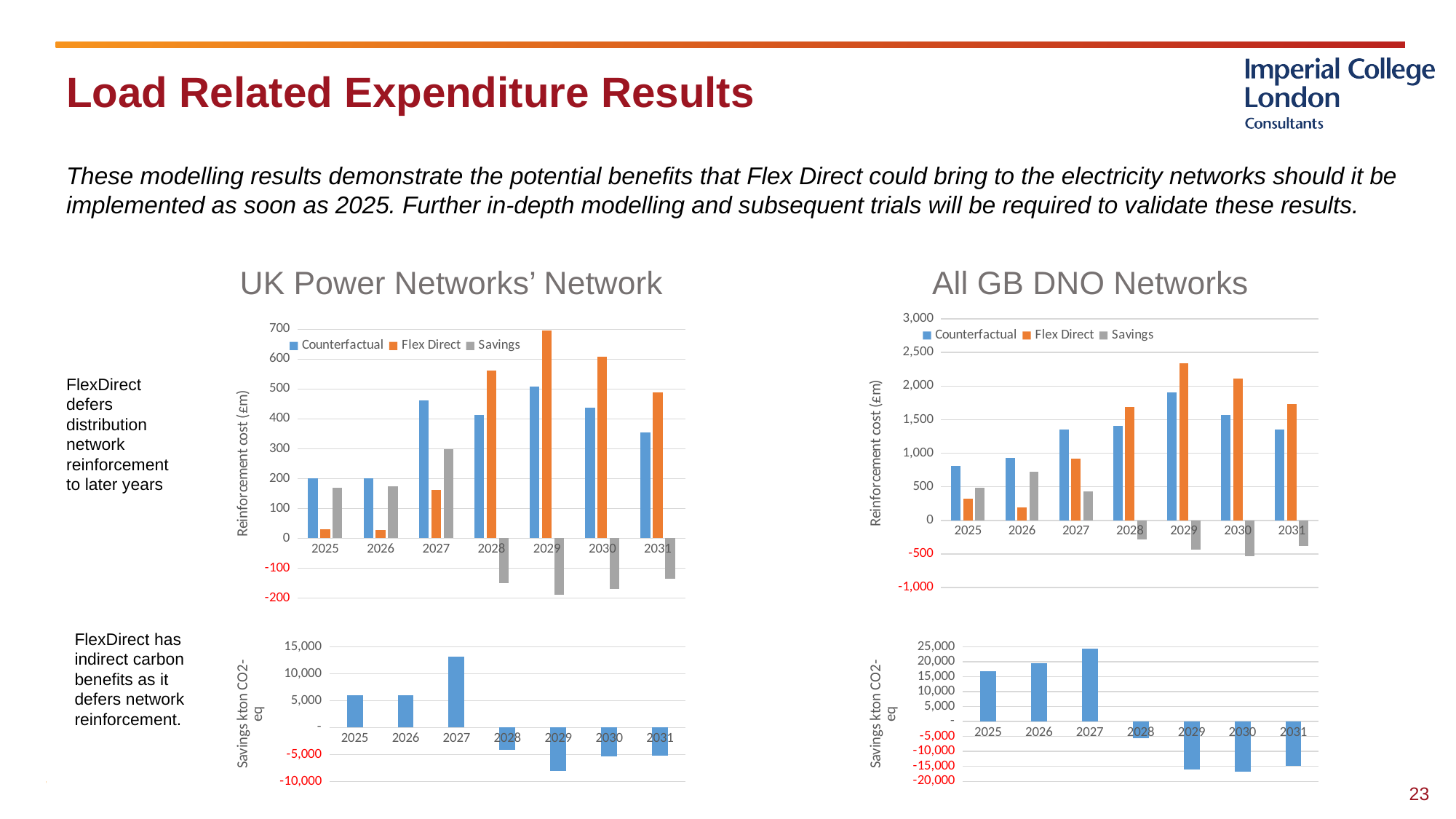
In the top chart under 'UK Power Networks' Network', which year has the highest Flex Direct reinforcement cost? 2029 In the top chart under 'All GB DNO Networks', which year has the highest Flex Direct reinforcement cost? 2029 In the bottom chart under 'UK Power Networks' Network', which year has the highest savings in kton CO2-eq? 2027 In the top chart under 'UK Power Networks' Network', is the Flex Direct value for 2025 greater or less than 100? less In the top chart under 'UK Power Networks' Network', which is larger in 2026, Counterfactual or Flex Direct? Counterfactual In the top chart under 'UK Power Networks' Network', how many series does the legend list? 3 In the top chart under 'UK Power Networks' Network', is the Counterfactual value for 2027 greater or less than 400? greater How many years are shown on the x axis of the top chart under 'UK Power Networks' Network'? 7 What kind of chart is the bottom chart under 'All GB DNO Networks'? bar chart In the bottom chart under 'All GB DNO Networks', is the savings value for 2029 greater or less than -10,000? less